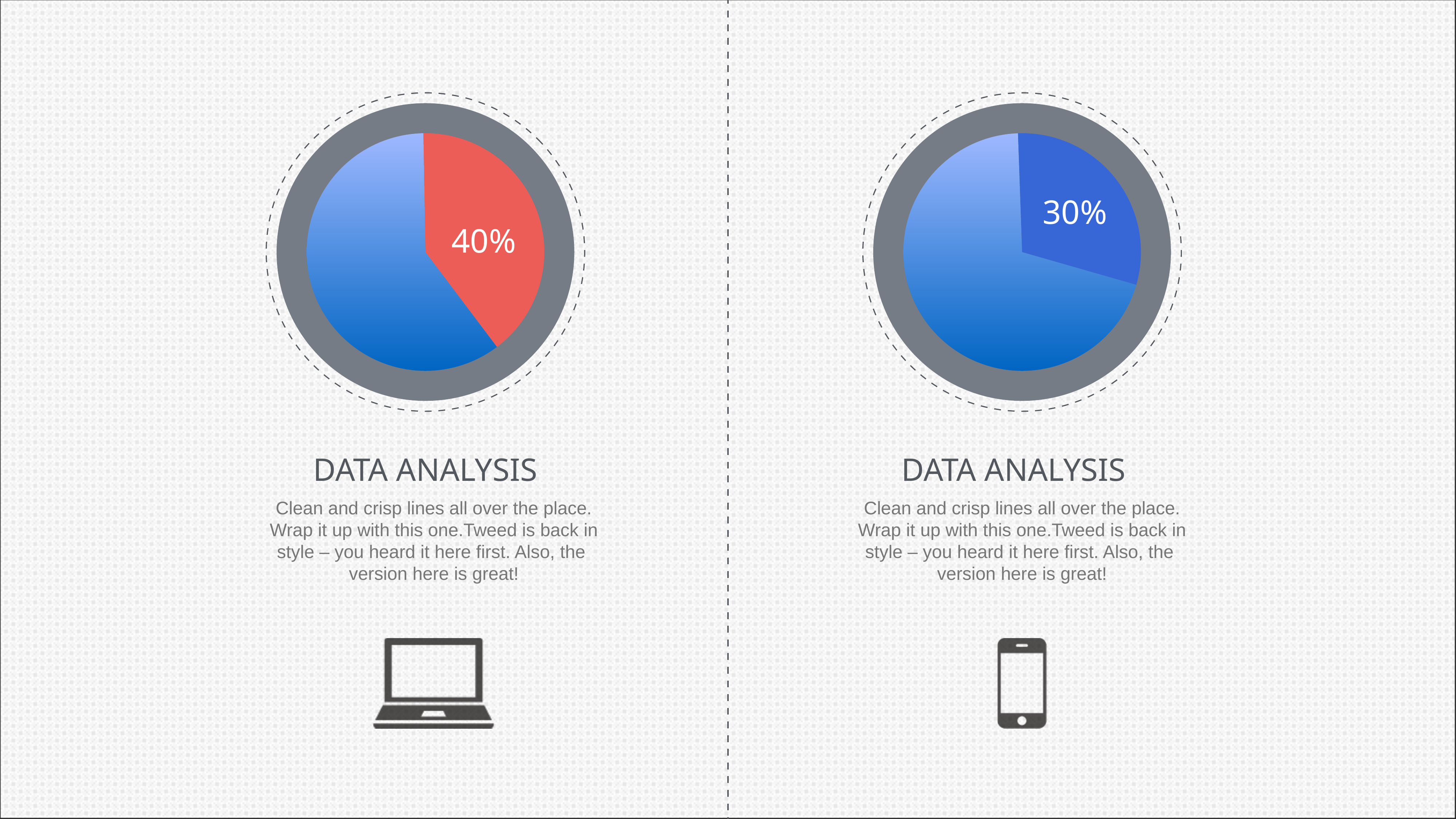
In the right pie chart, what value is printed on the dark blue slice? 30% What title appears below each pie chart on the slide? DATA ANALYSIS What is the difference between the labelled slice in the left pie chart (40%) and the labelled slice in the right pie chart (30%)? 10% In the left pie chart, is the red slice larger or smaller than the blue slice? smaller What kind of chart is shown on the right side of the slide? pie chart What colour is the slice labelled 40% in the left pie chart? red In the left pie chart, what value is printed on the red slice? 40% How many slices does the right pie chart have? 2 Which is larger: the labelled slice in the left pie chart or the labelled slice in the right pie chart? the left pie chart's slice (40%) What kind of chart is shown on the left side of the slide? pie chart How many slices does the left pie chart have? 2 In the right pie chart, is the dark blue slice larger or smaller than the light blue slice? smaller